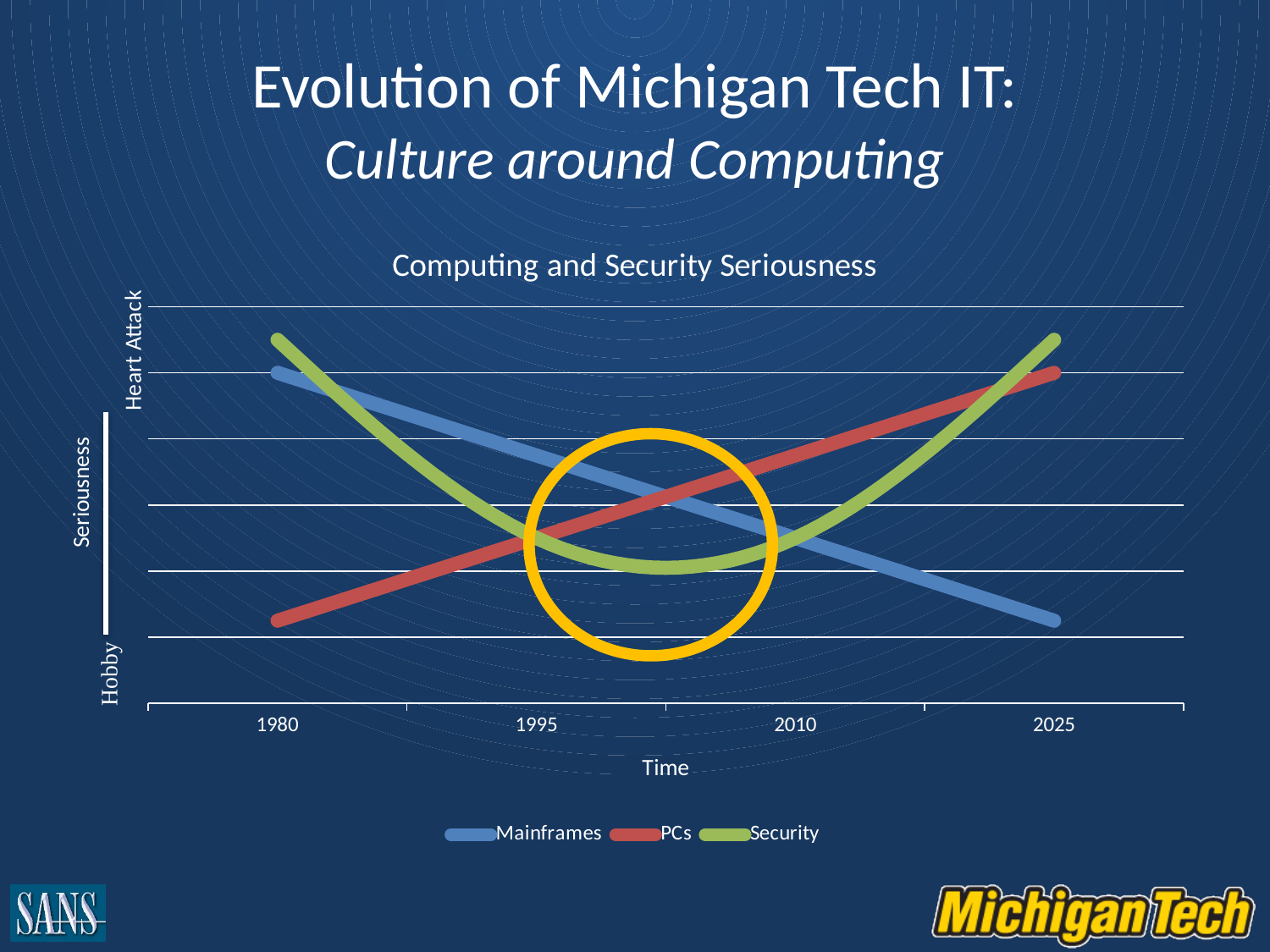
Which series has the highest value at 1980? Security What label is shown on the x axis of the chart? Time What kind of chart is shown on the slide? Line chart What is the title of the chart? Computing and Security Seriousness At 1980, which is higher: Mainframes or PCs? Mainframes Does the PCs line rise or fall from 1980 to 2025? Rise At 2025, which is higher: Security or Mainframes? Security Does the Mainframes line rise or fall from 1980 to 2025? Fall How many year labels are shown on the x axis of the chart? 4 How many series does the legend of the chart list? 3 Which series has the lowest value at 1980? PCs Which series has the lowest value at 2025? Mainframes